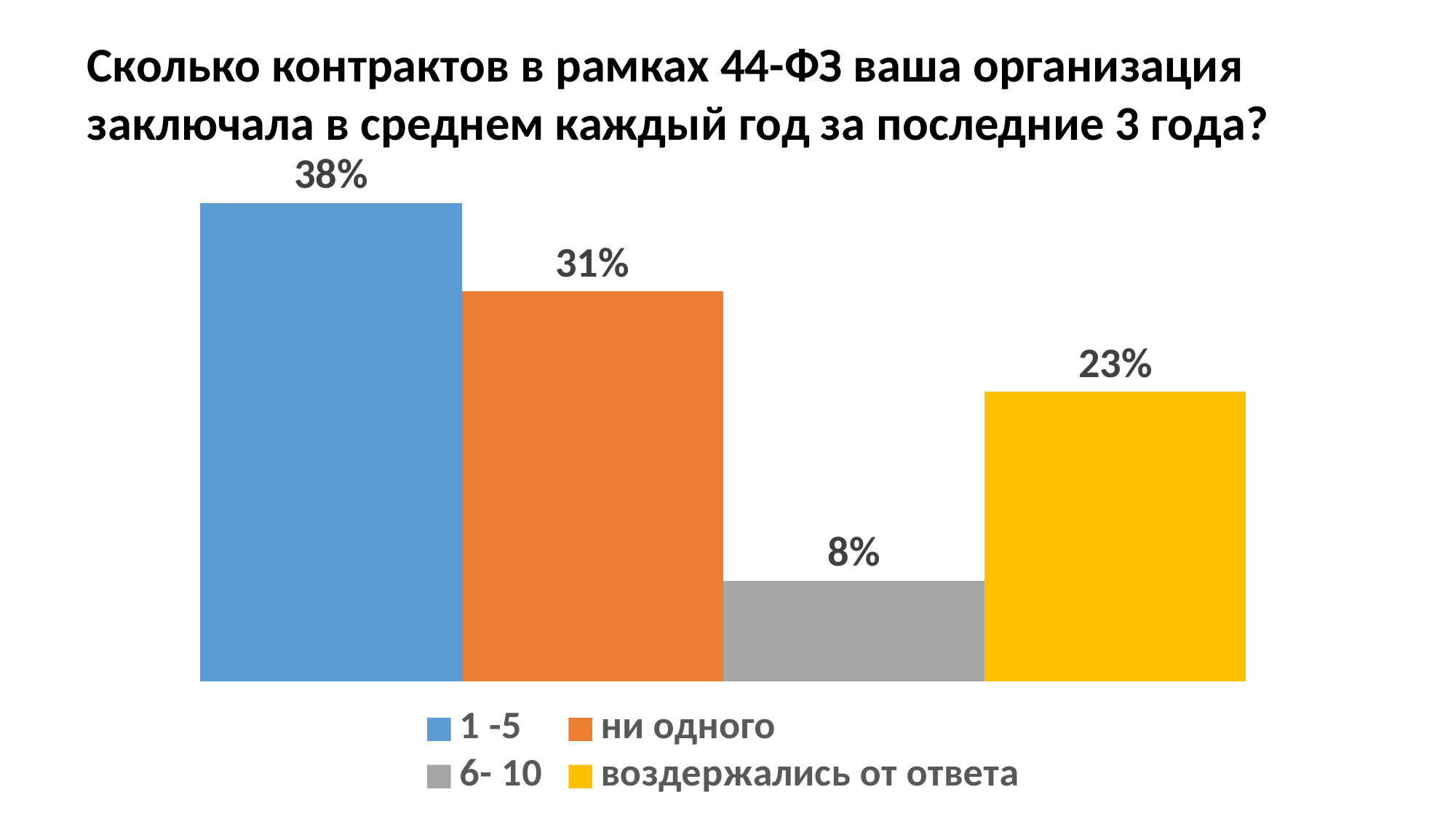
What percentage is shown for 'воздержались от ответа'? 23% How many categories are shown in the chart? 4 Which category has the highest value? 1 -5 Which category has the lowest value? 6- 10 What colour is the bar for '6- 10'? grey What is the difference between the values for 'воздержались от ответа' and '6- 10'? 15% What percentage is shown for '6- 10'? 8% What percentage is shown for the '1 -5' category? 38% What type of chart is shown on the slide? bar chart Which is larger: the value for 'ни одного' or for 'воздержались от ответа'? ни одного What is the difference between the values for '1 -5' and 'ни одного'? 7% What percentage is shown for 'ни одного'? 31%